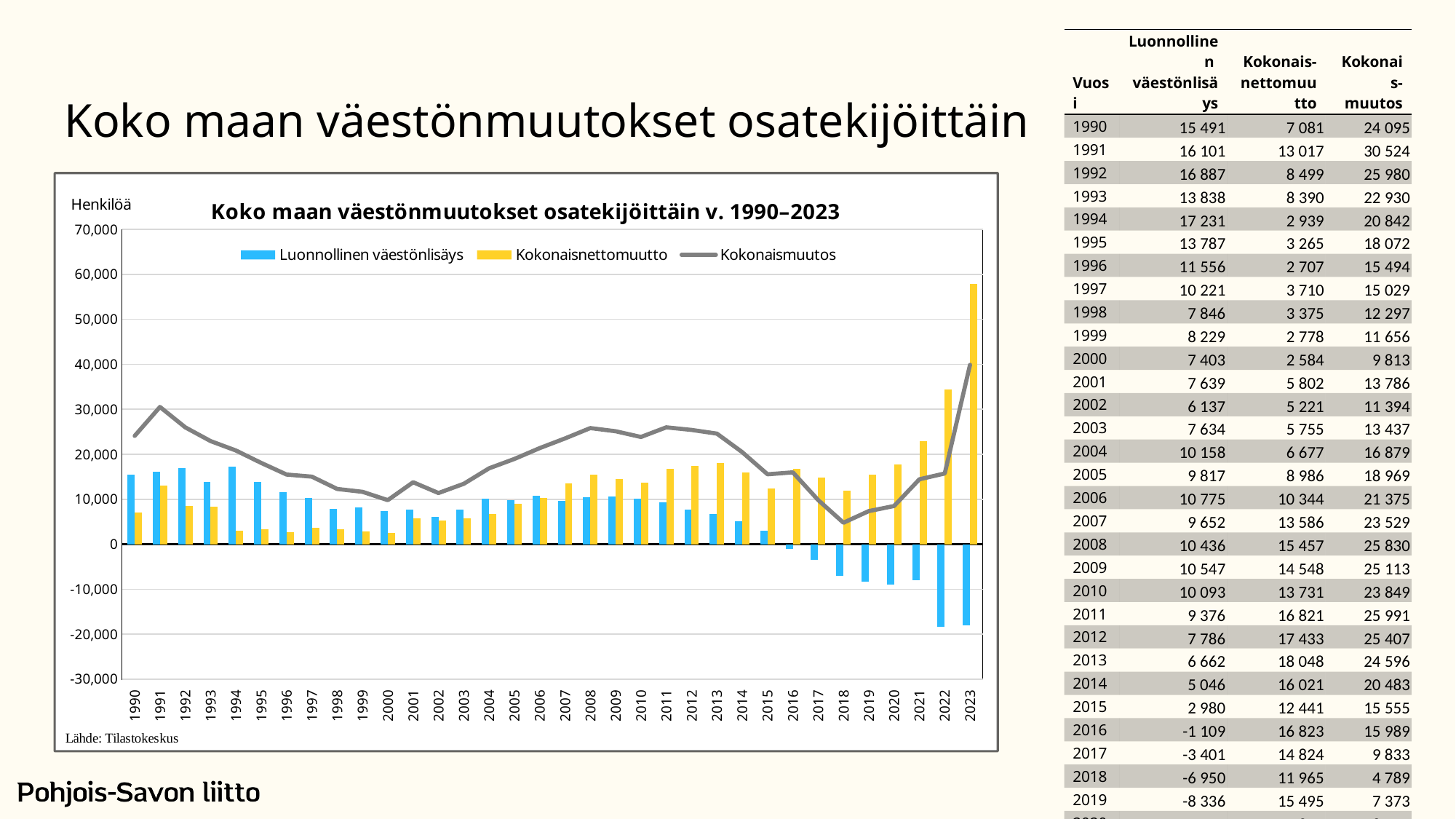
Does the Kokonaismuutos line rise or fall from 2018 to 2023? rise According to the table, what is the Luonnollinen väestönlisäys value for 2016? -1 109 Is the Kokonaisnettomuutto value for 2023 greater or less than 50,000? greater What kind of chart is shown on the slide? bar chart with a line In which year is Kokonaisnettomuutto highest? 2023 How many series does the chart legend list? 3 In which year is the Kokonaismuutos line at its lowest? 2018 Using the table, what is the difference between Kokonaisnettomuutto in 2013 and in 2012? 615 How many years are plotted along the x axis of the chart? 34 According to the table, what is the Kokonaismuutos value for 1991? 30 524 Is the Luonnollinen väestönlisäys value for 2022 greater or less than -10,000? less Which series is drawn as a grey line in the chart? Kokonaismuutos